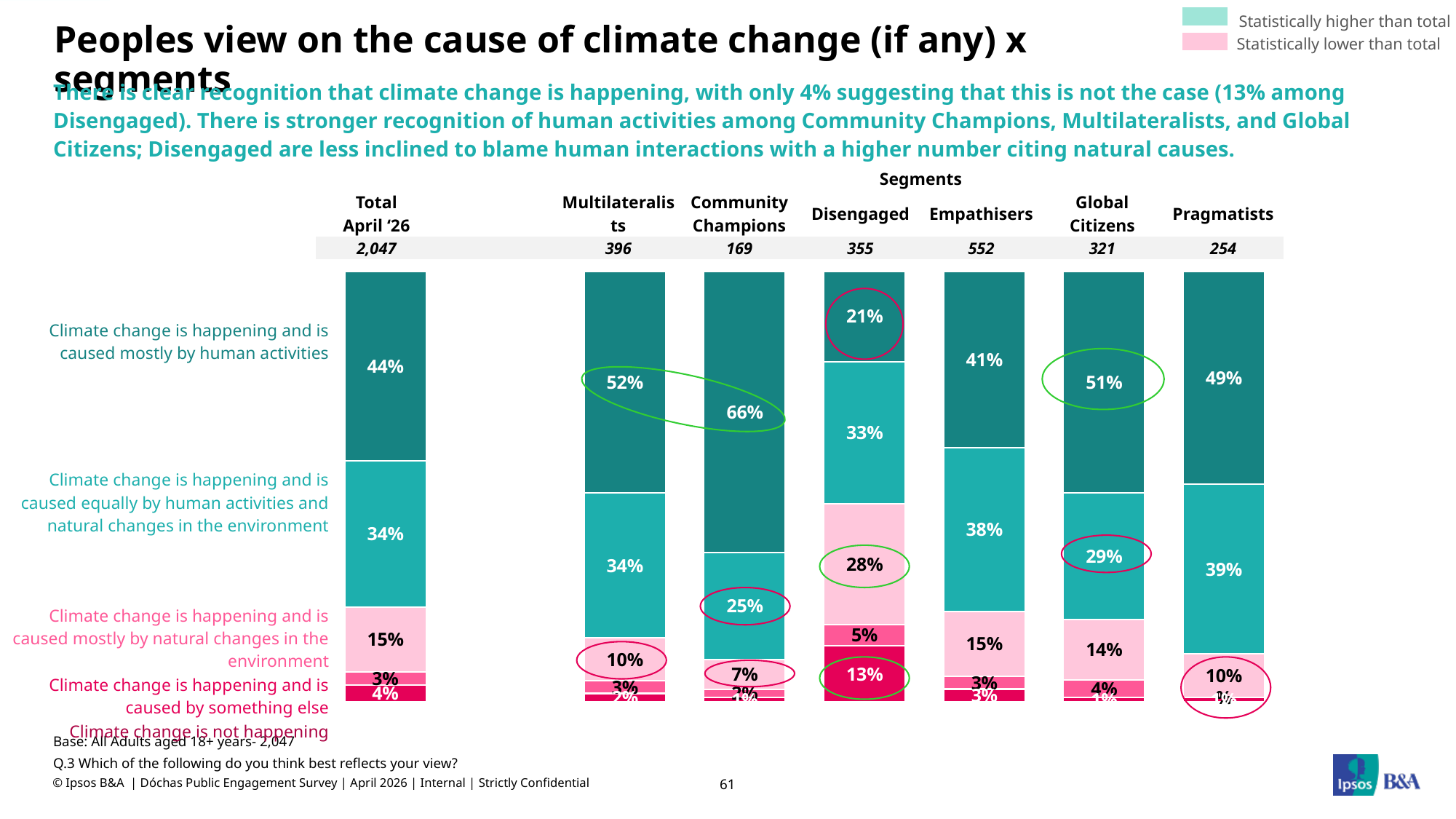
What percentage of the Disengaged segment say climate change is caused mostly by natural changes in the environment? 28% What percentage of Community Champions say climate change is happening and is caused mostly by human activities? 66% What percentage of the Total April '26 sample say climate change is happening and is caused mostly by human activities? 44% What percentage of the Disengaged segment say climate change is not happening? 13% What type of chart is shown on the slide? Stacked bar chart Which segment has the highest share saying climate change is caused mostly by human activities? Community Champions How many percentage points higher is the 'mostly by human activities' share for Community Champions than for the Total? 22 percentage points Which segment has the highest share saying climate change is caused mostly by natural changes in the environment? Disengaged Which has a larger share saying climate change is caused equally by human activities and natural changes: Empathisers or Global Citizens? Empathisers How many bars (columns) are shown in the chart, including the Total? 7 What percentage of Pragmatists say climate change is caused equally by human activities and natural changes? 39% Which segment has the lowest share saying climate change is caused mostly by human activities? Disengaged